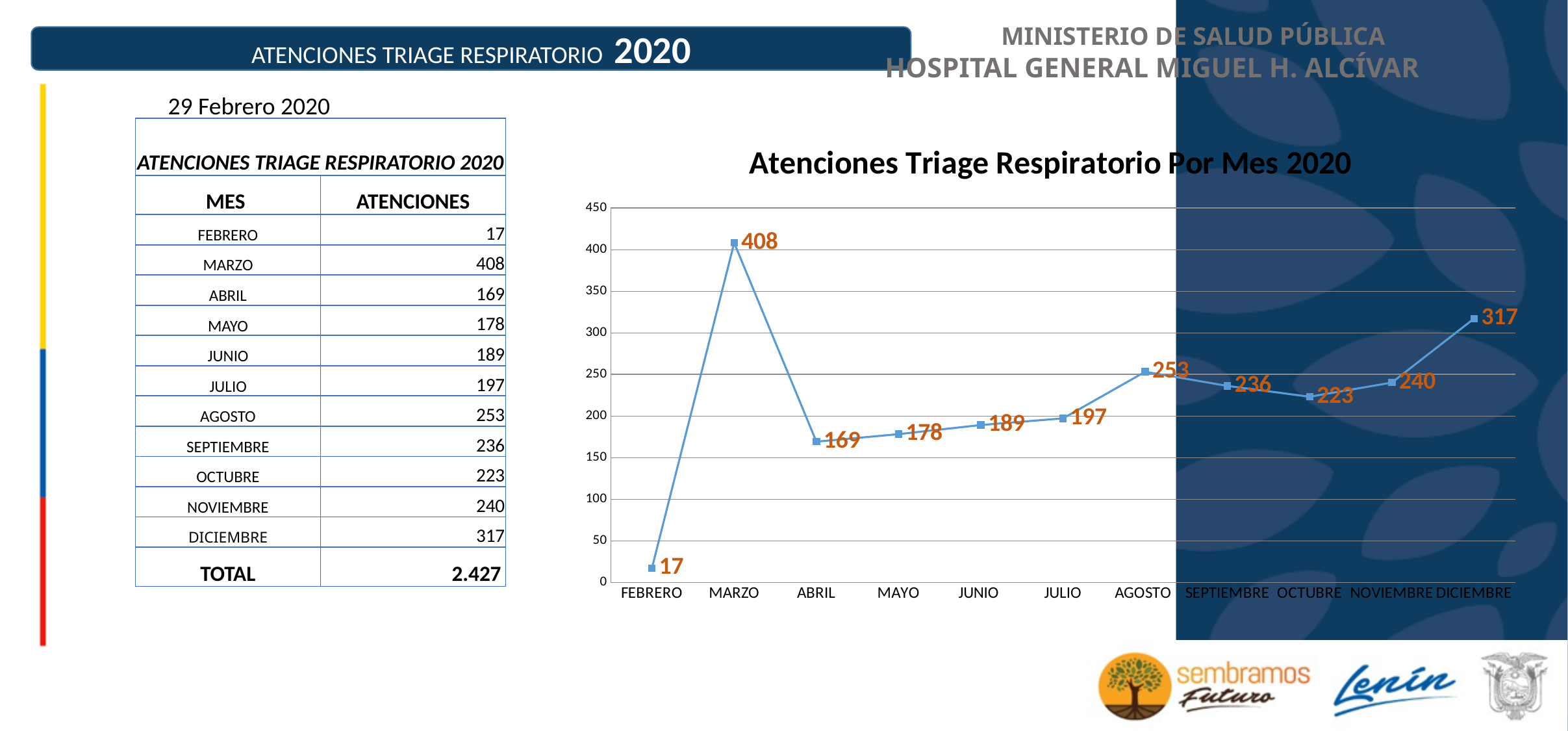
What is the difference between the values for DICIEMBRE and NOVIEMBRE? 77 What is the value for MARZO in the chart? 408 How many months are plotted on the x axis of the chart? 11 What is the value for DICIEMBRE in the chart? 317 What kind of chart is shown on the slide? line chart What is the title of the chart? Atenciones Triage Respiratorio Por Mes 2020 Which is larger, the value for AGOSTO or the value for OCTUBRE? AGOSTO Which month has the lowest value in the chart? FEBRERO What is the value for FEBRERO in the chart? 17 Is the value for SEPTIEMBRE greater or less than 250? less Which month has the highest value in the chart? MARZO What is the difference between the values for MARZO and ABRIL? 239